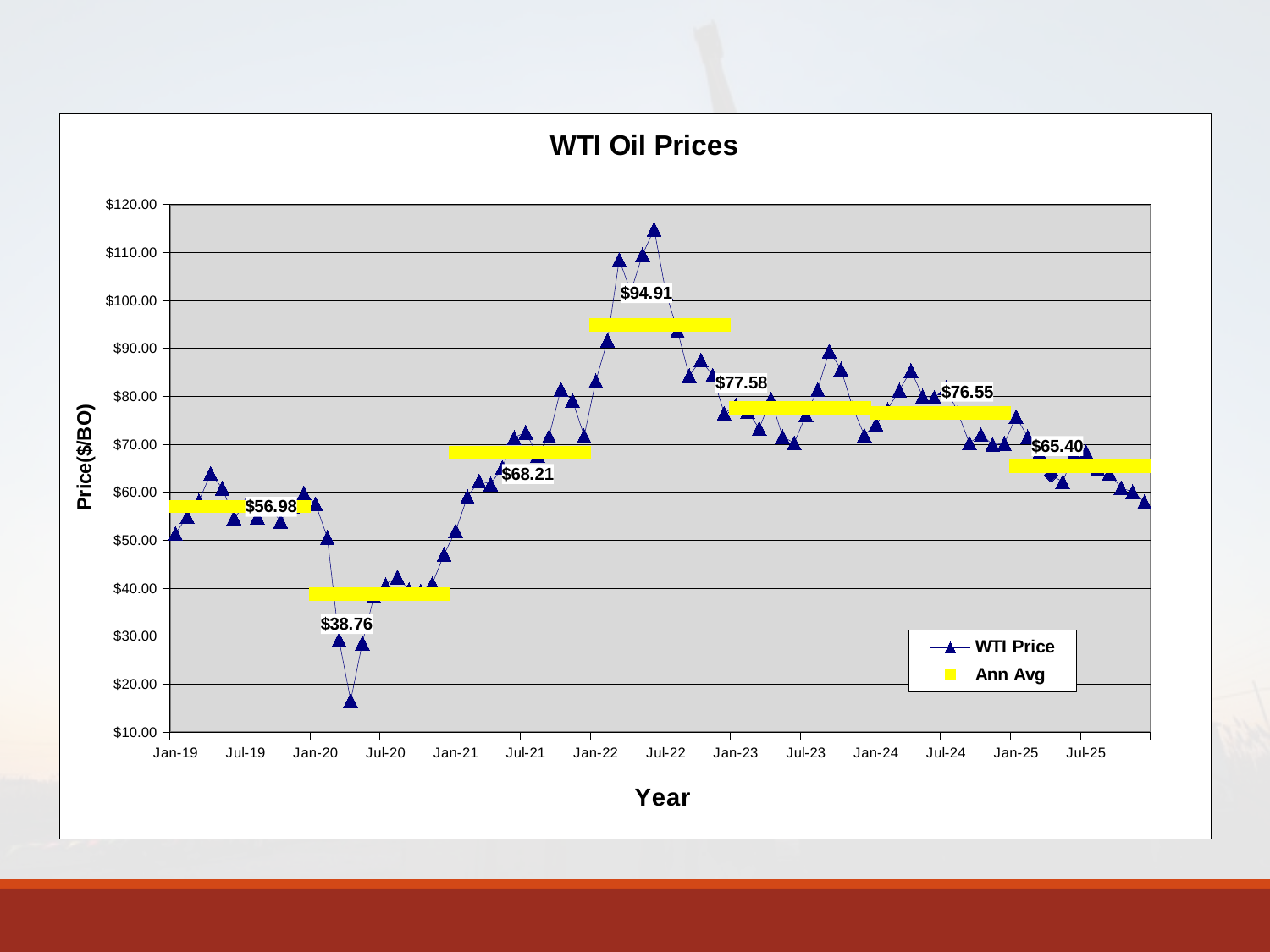
Which year has the highest labelled annual average price? 2022 What is the annual average WTI oil price shown for 2025? $65.40 Which is larger, the 2023 annual average or the 2024 annual average? 2023 annual average ($77.58) Is the peak WTI price around Jul-22 greater or less than $110.00? greater What is the annual average WTI oil price shown for 2022? $94.91 What is the label on the vertical axis? Price($/BO) What is the difference between the 2022 annual average ($94.91) and the 2020 annual average ($38.76)? $56.15 How many series does the legend list? 2 Is the lowest WTI price in 2020 greater or less than $20.00? less What is the annual average WTI oil price shown for 2019? $56.98 Which year has the lowest labelled annual average price? 2020 What is the annual average WTI oil price shown for 2020? $38.76